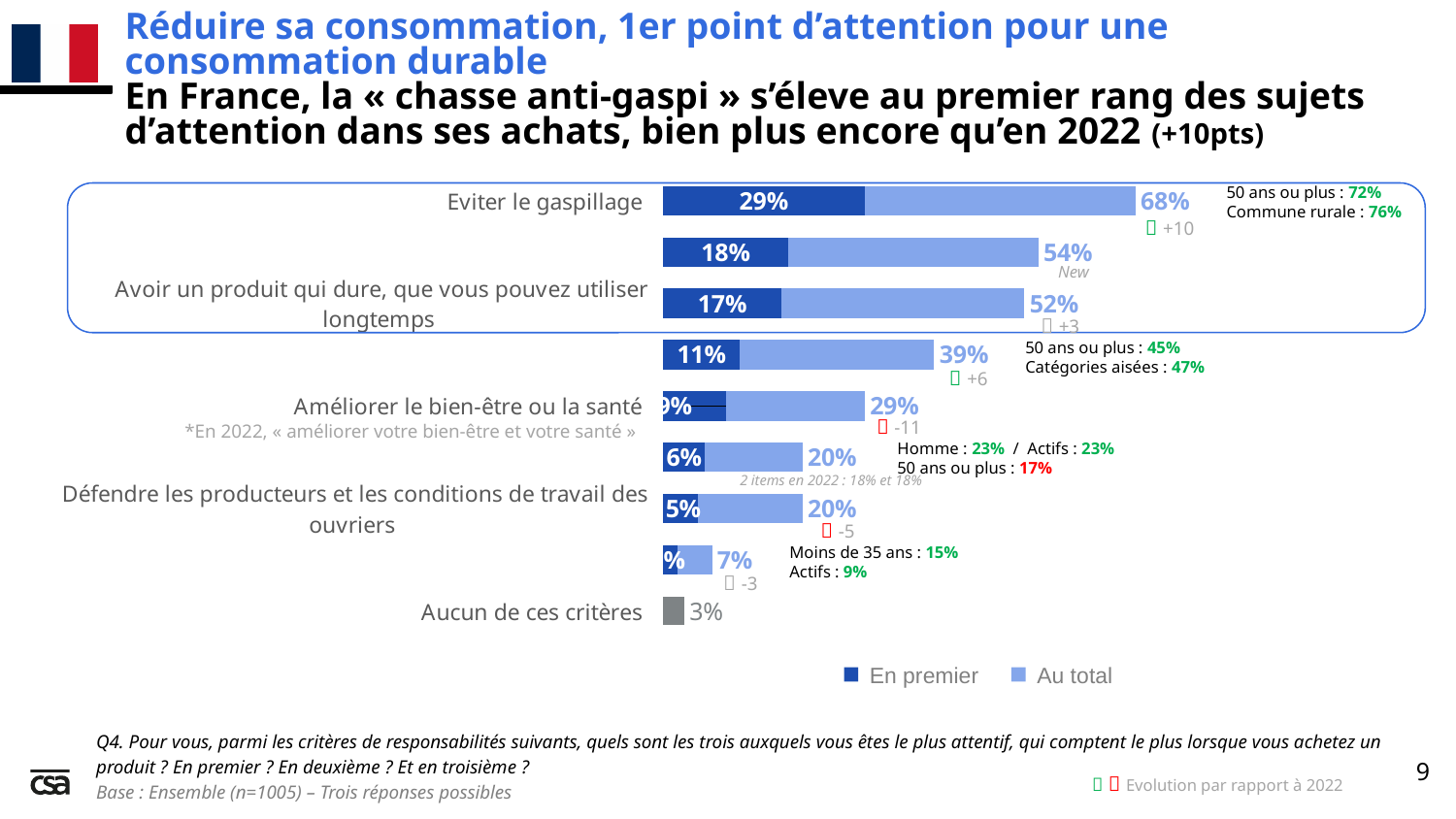
Which category has the highest 'Au total' value? Eviter le gaspillage What is the 'En premier' value for 'Eviter le gaspillage'? 29% What is the 'En premier' value for 'Avoir un produit qui dure, que vous pouvez utiliser longtemps'? 17% What is the value shown for 'Aucun de ces critères'? 3% What is the 'Au total' value for 'Défendre les producteurs et les conditions de travail des ouvriers'? 20% What is the 'En premier' value for 'Défendre les producteurs et les conditions de travail des ouvriers'? 5% What kind of chart is shown on the slide? Bar chart Which has the larger 'Au total' value: 'Eviter le gaspillage' or 'Avoir un produit qui dure, que vous pouvez utiliser longtemps'? Eviter le gaspillage What is the 'Au total' value for 'Avoir un produit qui dure, que vous pouvez utiliser longtemps'? 52% How many series does the legend list? 2 What is the 'Au total' value for 'Eviter le gaspillage'? 68% What is the difference between the 'Au total' and 'En premier' values for 'Eviter le gaspillage'? 39 points